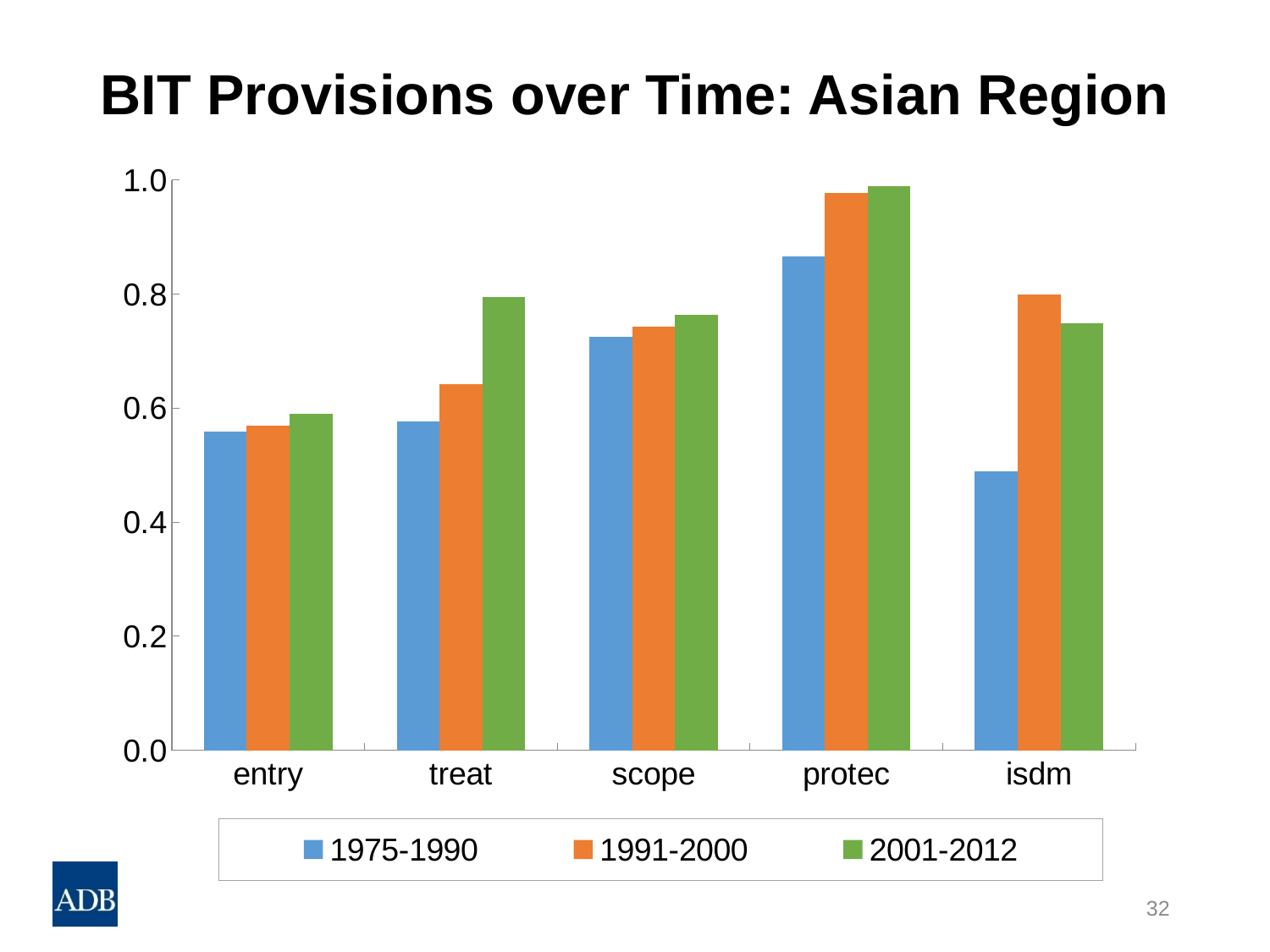
How many categories are shown on the x axis? 5 Is the value for treat in the 1991-2000 series greater or less than 0.6? greater Which category has the highest value for the 1975-1990 series? protec What kind of chart is shown on the slide? bar chart Which category has the lowest value for the 2001-2012 series? entry What is the title of the chart? BIT Provisions over Time: Asian Region Is the value for isdm in the 1975-1990 series greater or less than 0.6? less Is the value for protec in the 1975-1990 series greater or less than 0.8? greater Which category has the lowest value for the 1975-1990 series? isdm For treat, which series has the larger value: 1991-2000 or 2001-2012? 2001-2012 For isdm, which series has the larger value: 1991-2000 or 2001-2012? 1991-2000 How many series does the legend list? 3